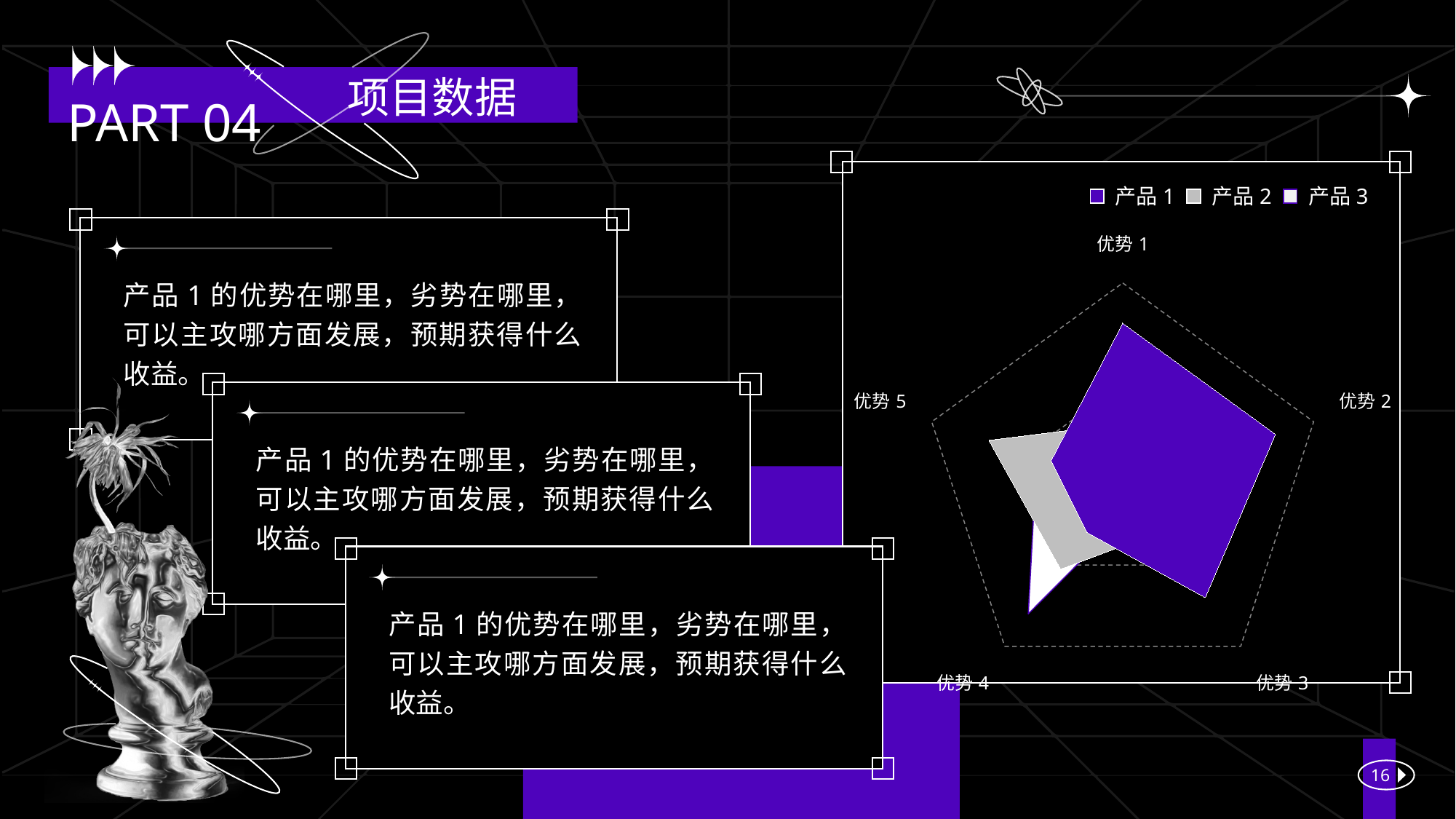
How many axes (categories) does the radar chart have? 5 What is the label of the axis at the top of the radar chart? 优势 1 What are the names of the series listed in the chart legend? 产品 1, 产品 2, 产品 3 Which series covers the smallest area on the radar chart? 产品 3 Which series is drawn in purple on the radar chart? 产品 1 What kind of chart is shown on the slide? radar chart How many series does the chart legend list? 3 Which series covers the largest area on the radar chart? 产品 1